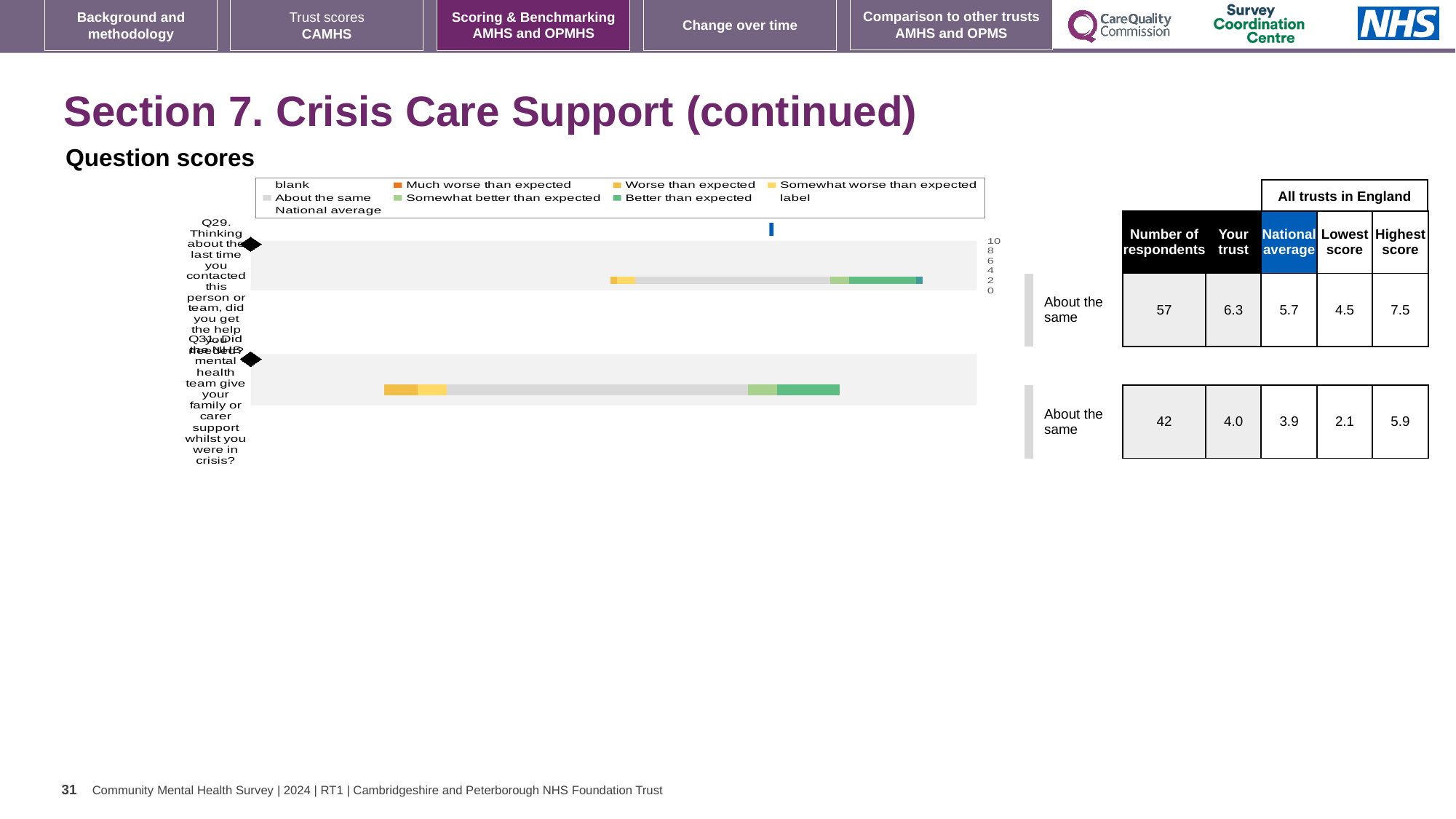
Which legend entry is shown in grey in the chart? About the same What is the highest tick value shown on the chart's axis? 10 What is the 'Your trust' score for Q31 shown alongside the chart? 4.0 What kind of chart is shown on the slide? bar chart What is the 'Your trust' score for Q29 shown alongside the chart? 6.3 How many entries does the chart's legend list? 9 What is the national average for Q31 shown alongside the chart? 3.9 What is the highest score across all trusts in England for Q29? 7.5 Which question has the higher 'Your trust' score, Q29 or Q31? Q29 How many questions (bars) are plotted in the chart? 2 What is the difference between the 'Your trust' scores for Q29 and Q31? 2.3 How many respondents are listed for Q29? 57